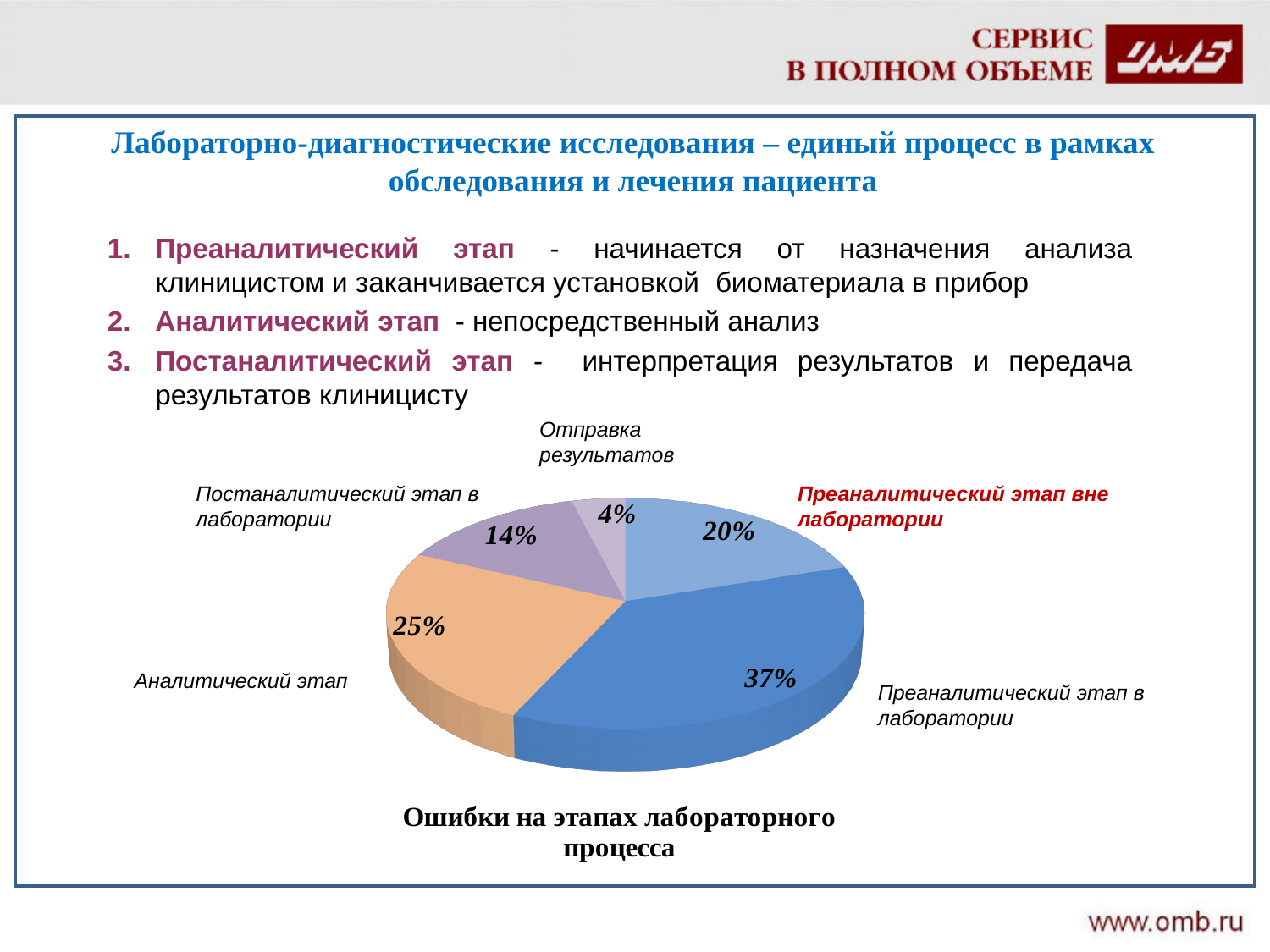
What share of the pie is labelled "Отправка результатов"? 4% How many slices does the pie chart have? 5 What share of the pie is labelled "Аналитический этап"? 25% What share of the pie is labelled "Постаналитический этап в лаборатории"? 14% Which slice of the pie is the largest? Преаналитический этап в лаборатории What kind of chart is shown on the slide? Pie chart Which is larger: the share for "Преаналитический этап вне лаборатории" or the share for "Постаналитический этап в лаборатории"? Преаналитический этап вне лаборатории What is the title of the chart? Ошибки на этапах лабораторного процесса What is the difference between the shares for "Преаналитический этап в лаборатории" and "Аналитический этап"? 12% Which slice of the pie is the smallest? Отправка результатов